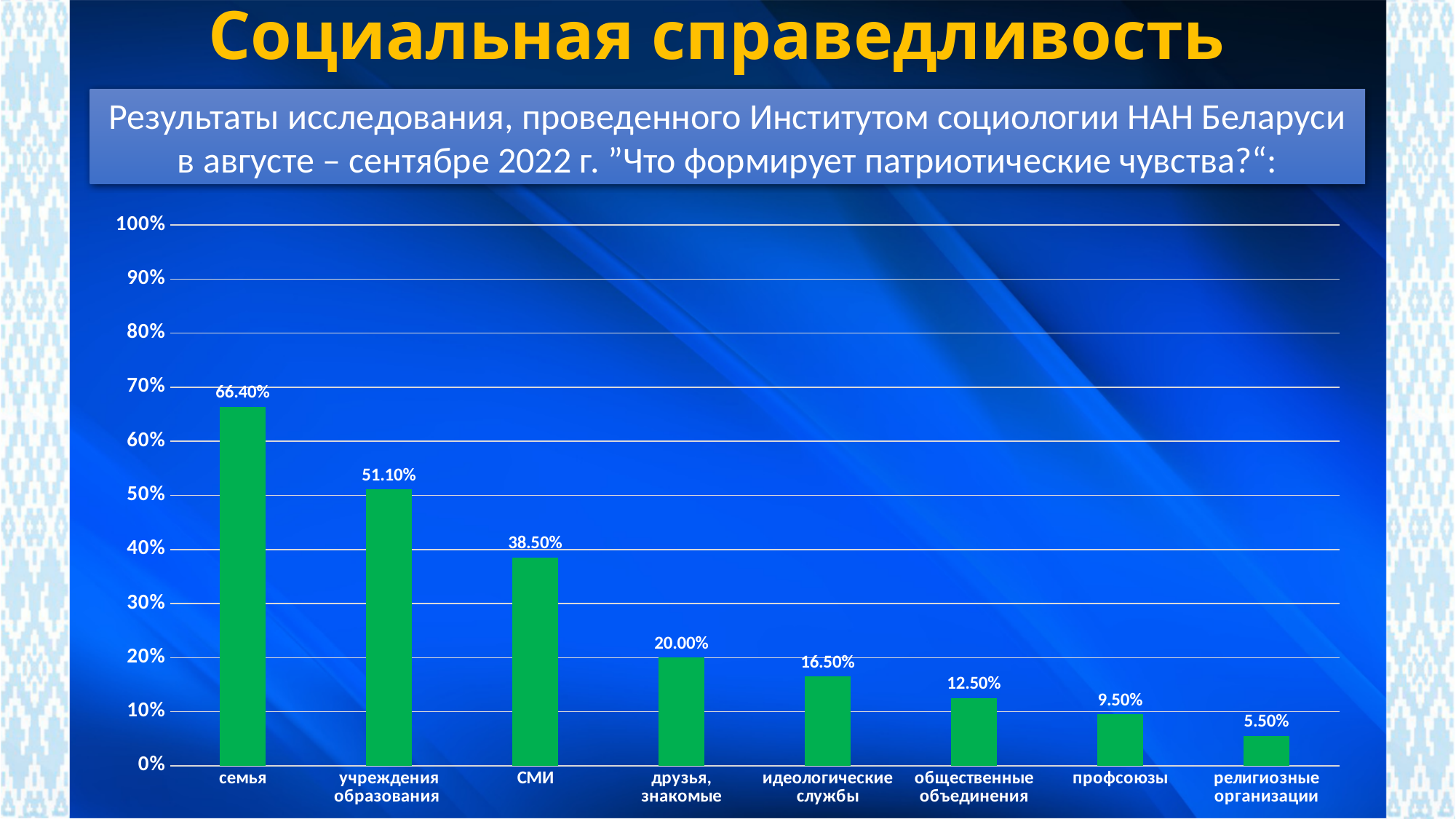
What is the value for идеологические службы? 16.50% What is the value for СМИ? 38.50% Which is larger, the value for СМИ or the value for друзья, знакомые? СМИ What kind of chart is shown on the slide? bar chart What is the value for семья? 66.40% Which category has the highest value? семья What is the difference between the values for семья and учреждения образования? 15.30% Which category has the lowest value? религиозные организации What is the difference between the values for друзья, знакомые and общественные объединения? 7.50% What is the value for профсоюзы? 9.50% How many categories are shown on the chart? 8 Do the values rise or fall from left to right along the x axis? fall